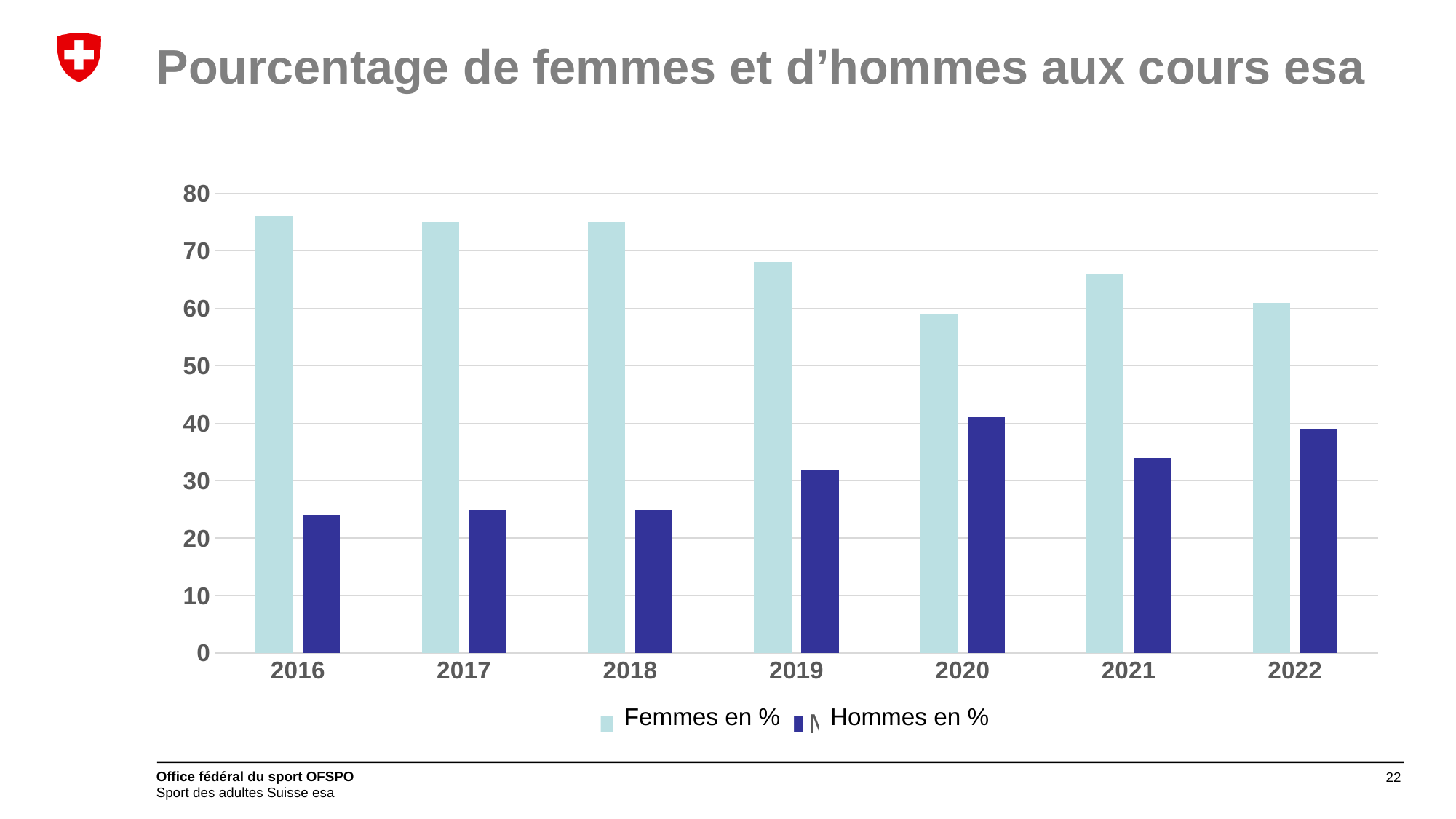
What kind of chart is shown on the slide? bar chart How many series does the legend list? 2 Is the value for Hommes en % in 2016 greater or less than 30? less Which is larger for Hommes en %, the value in 2019 or the value in 2016? 2019 In 2020, which series has the larger value, Femmes en % or Hommes en %? Femmes en % Overall, do the Hommes en % values rise or fall from 2016 to 2022? rise Is the value for Femmes en % in 2016 greater or less than 70? greater How many years are shown on the x axis? 7 What is the title of the chart on the slide? Pourcentage de femmes et d’hommes aux cours esa